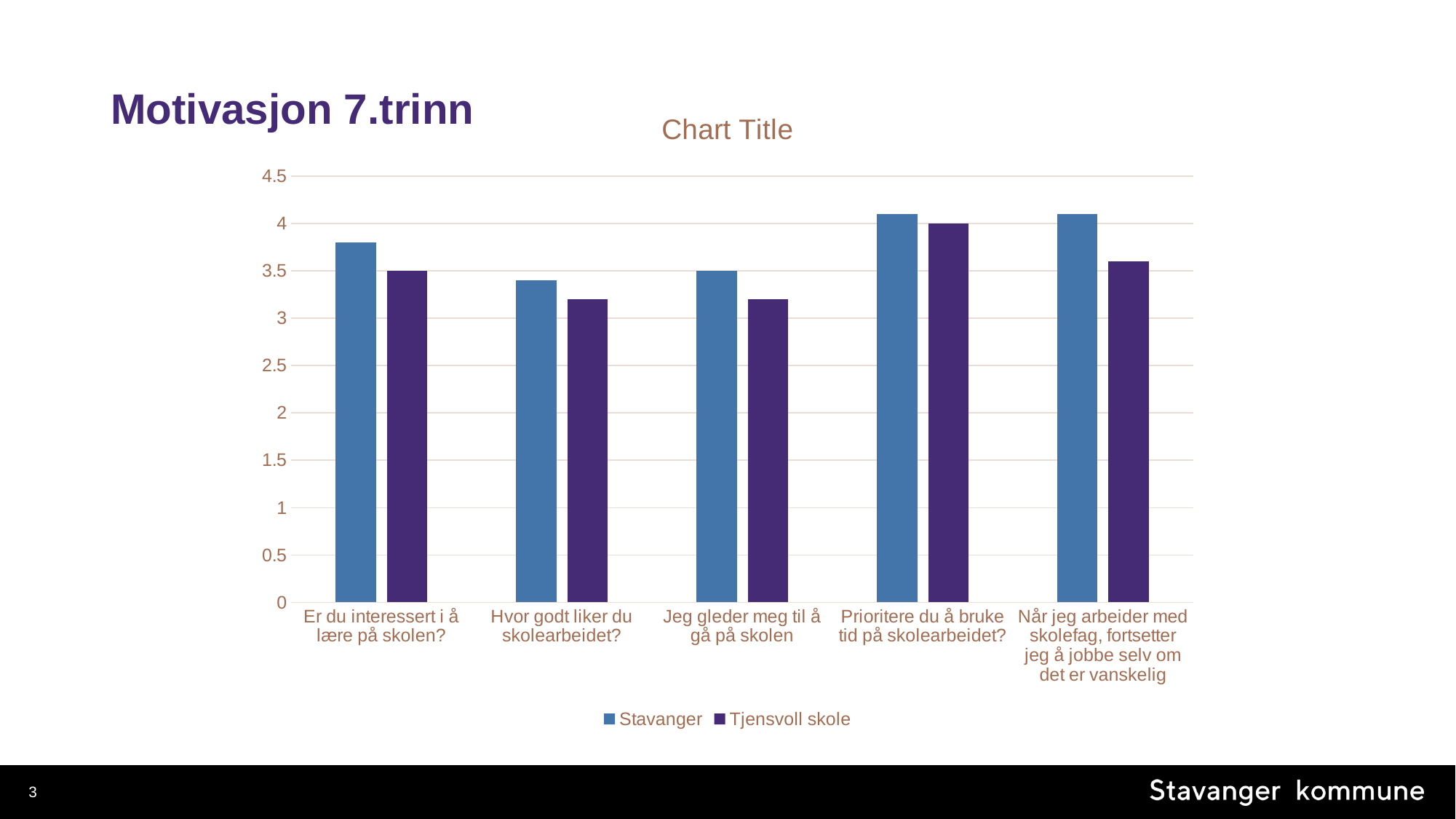
For which category is the Tjensvoll skole value highest? Prioritere du å bruke tid på skolearbeidet? Which series has the higher value for "Når jeg arbeider med skolefag, fortsetter jeg å jobbe selv om det er vanskelig", Stavanger or Tjensvoll skole? Stavanger Which series is shown in dark purple in the legend? Tjensvoll skole How many series does the legend list? 2 Is the Tjensvoll skole value for "Jeg gleder meg til å gå på skolen" greater or less than 3? greater What is the title shown above the chart? Chart Title Is the Tjensvoll skole value for "Hvor godt liker du skolearbeidet?" greater or less than 3.5? less How many question categories are shown on the x axis? 5 Which series has the higher value for "Er du interessert i å lære på skolen?", Stavanger or Tjensvoll skole? Stavanger Is the Stavanger value for "Prioritere du å bruke tid på skolearbeidet?" greater or less than 4? greater What kind of chart is shown on the slide? bar chart